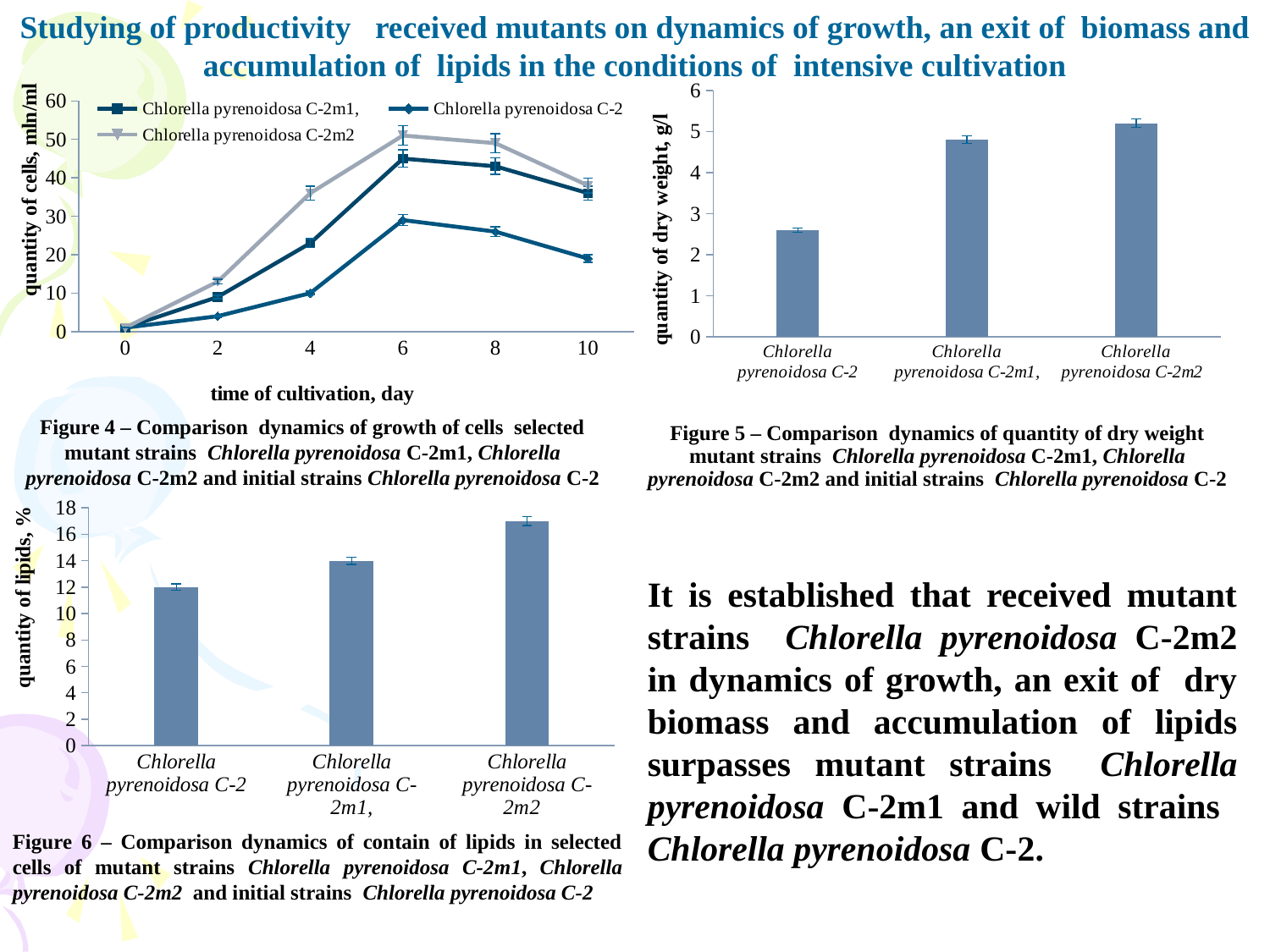
In Figure 4 (top-left), is the value for Chlorella pyrenoidosa C-2m2 at day 4 greater or less than 30? greater In Figure 6 (bottom-left), which strain has the highest quantity of lipids? Chlorella pyrenoidosa C-2m2 What kind of chart is Figure 5 (top-right)? bar chart In Figure 5 (top-right), is the value for Chlorella pyrenoidosa C-2 greater or less than 3? less In Figure 5 (top-right), which strain has the lowest quantity of dry weight? Chlorella pyrenoidosa C-2 How many bars are shown in Figure 6 (bottom-left)? 3 In Figure 6 (bottom-left), is the value for Chlorella pyrenoidosa C-2m2 greater or less than 16? greater What kind of chart is Figure 4 (top-left)? line chart In Figure 4 (top-left), does the quantity of cells for Chlorella pyrenoidosa C-2 rise or fall between day 6 and day 10? fall How many series does the legend of Figure 4 (top-left) list? 3 In Figure 4 (top-left), which strain has the highest quantity of cells at day 6? Chlorella pyrenoidosa C-2m2